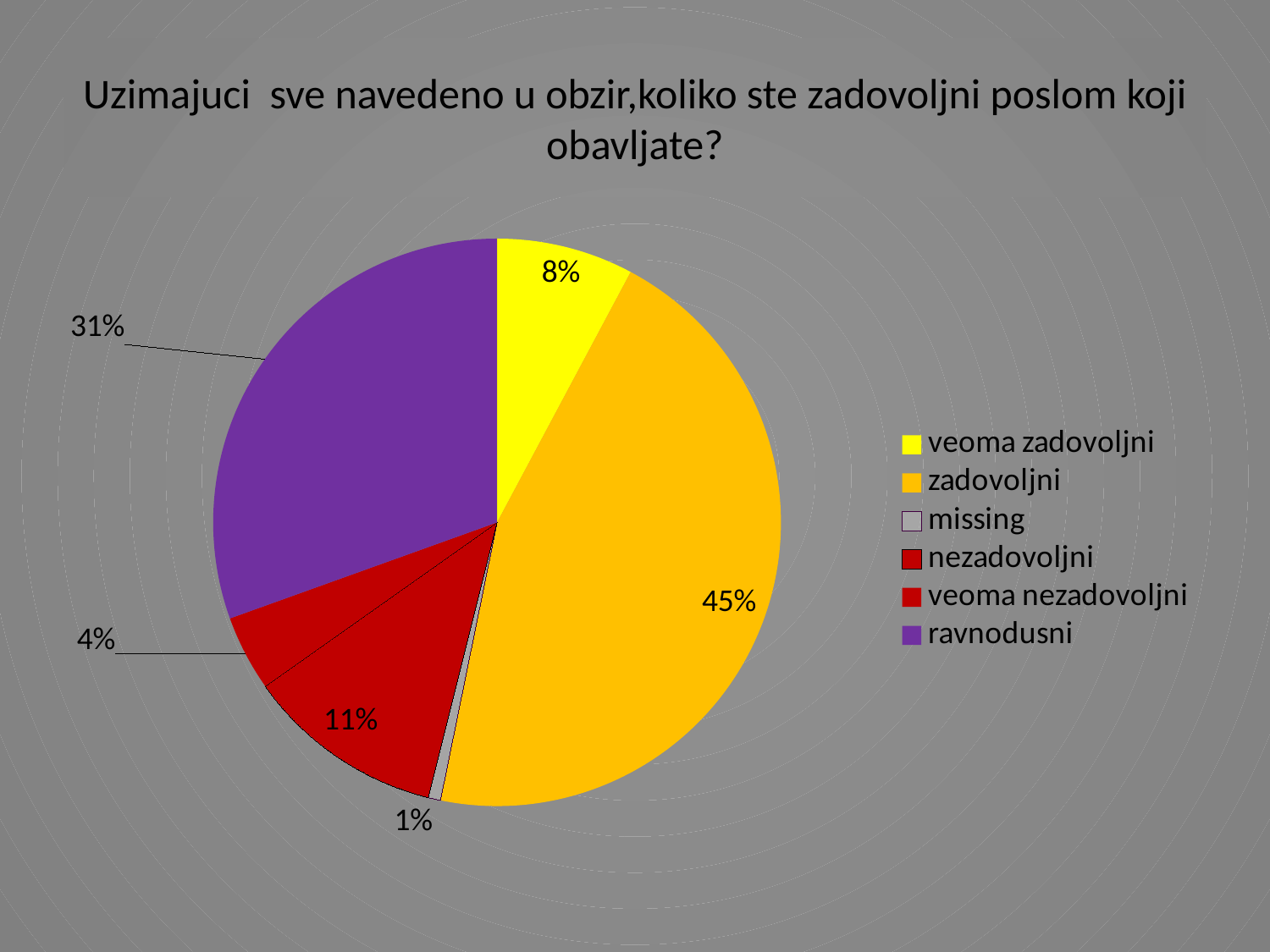
What percentage of the pie is labelled for the 'zadovoljni' slice? 45% Which slice is larger, 'nezadovoljni' or 'veoma nezadovoljni'? nezadovoljni Which category has the smallest share of the pie? missing How many categories does the legend list? 6 What type of chart is shown on the slide? pie chart What is the difference in percentage points between the 'zadovoljni' and 'ravnodusni' slices? 14 Which category has the largest share of the pie? zadovoljni What colour is the 'ravnodusni' slice? purple What percentage is shown for the 'nezadovoljni' slice? 11% What percentage is shown for the 'veoma zadovoljni' slice? 8% What percentage is shown for the 'ravnodusni' slice? 31% What percentage is shown for the 'missing' slice? 1%